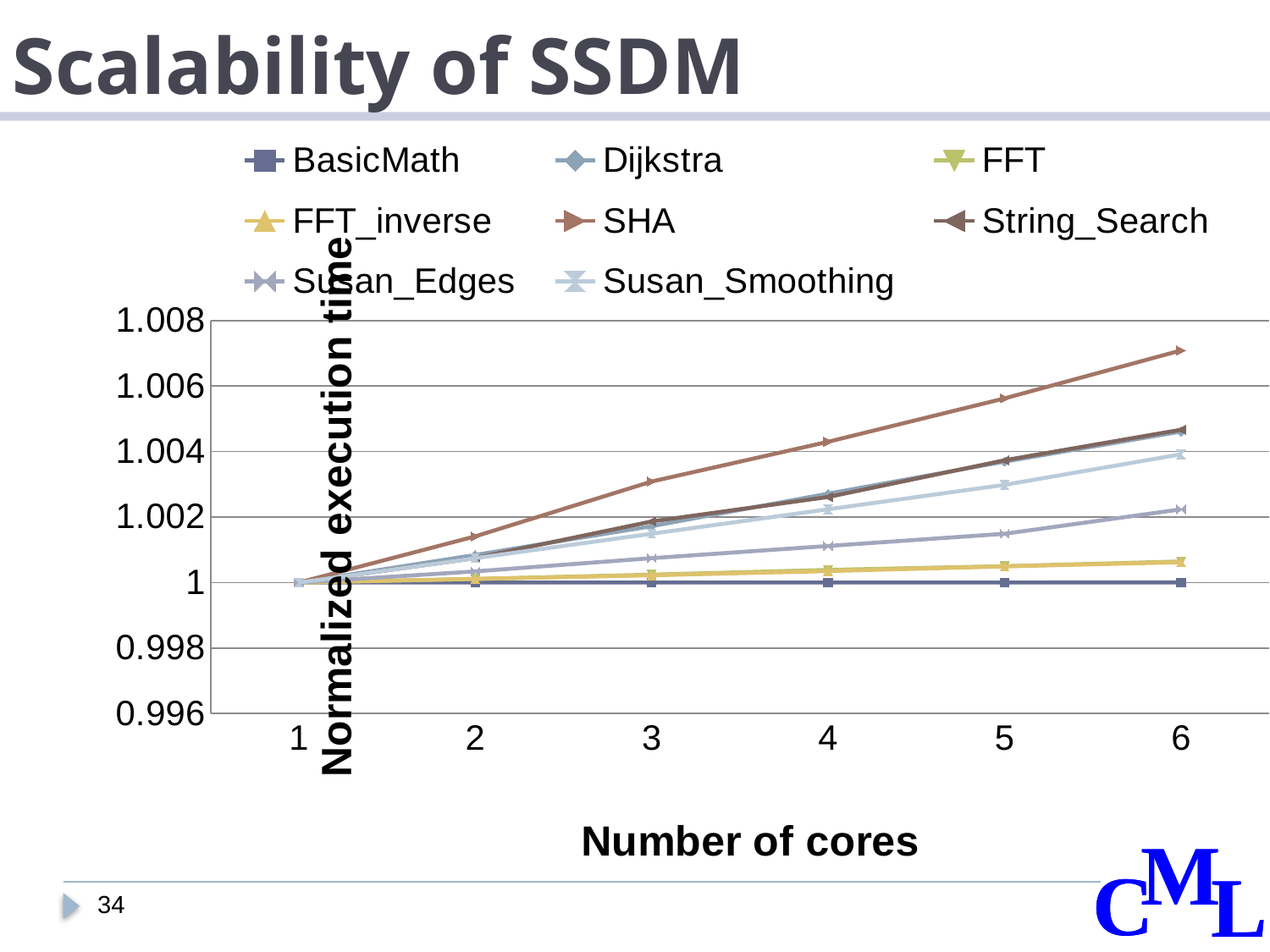
Is the value for Susan_Edges at 6 cores greater or less than 1.004? less How many core counts are plotted along the x axis? 6 What is the label of the x axis? Number of cores Does the normalized execution time for SHA rise or fall as the number of cores increases? rises At 6 cores, which is larger: the value for SHA or the value for Susan_Edges? SHA Is the value for SHA at 6 cores greater or less than 1.006? greater How many series does the legend list? 8 What kind of chart is shown on the slide? line chart What is the normalized execution time for SHA at 1 core? 1 Which series has the highest normalized execution time at 6 cores? SHA What is the label of the y axis? Normalized execution time Is the value for SHA at 5 cores greater or less than 1.004? greater